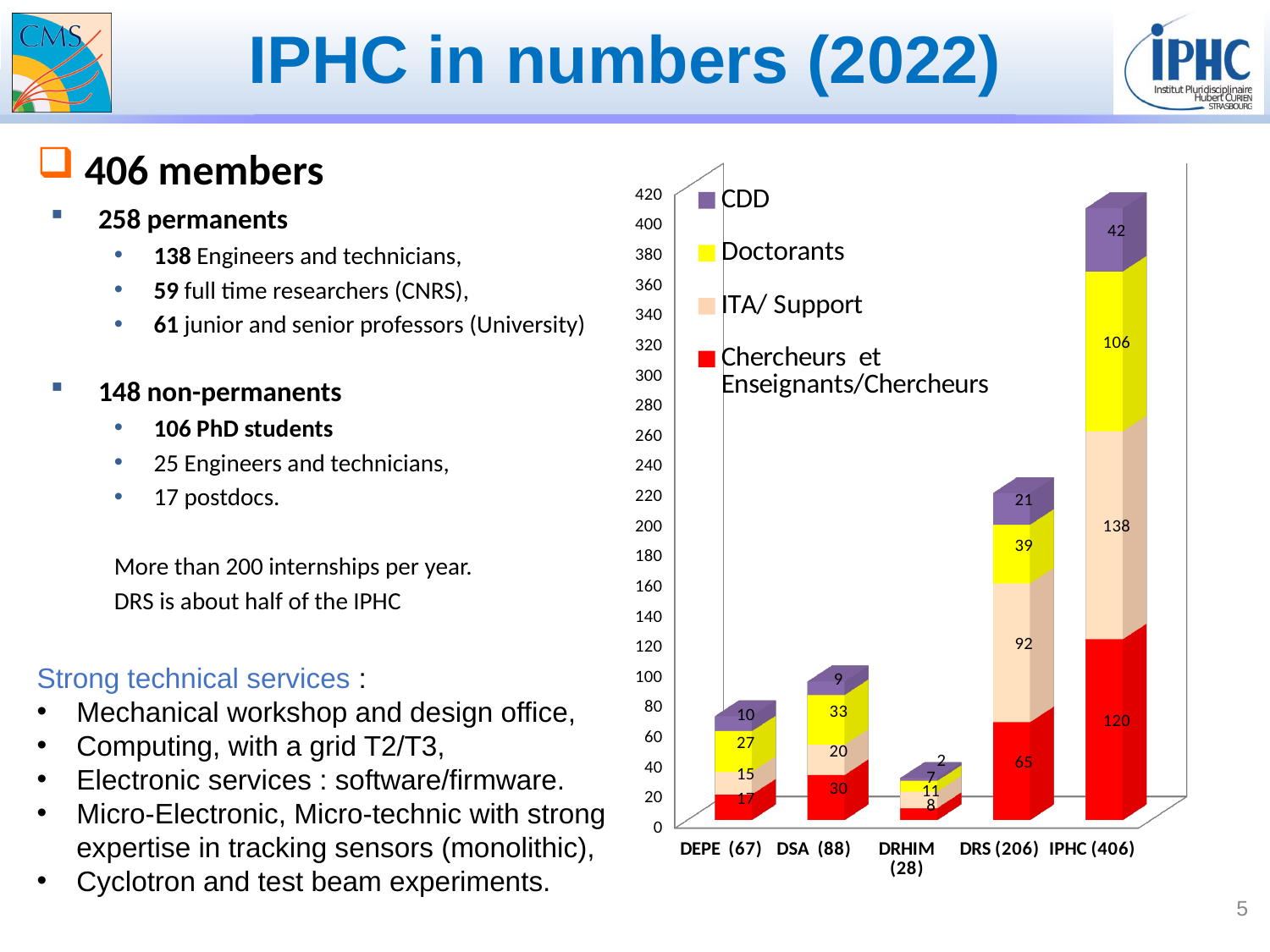
What is the value of the ITA/ Support segment for DSA (88)? 20 What is the value of the CDD segment for DEPE (67)? 10 How many series does the legend list? 4 Which category has the tallest stacked bar? IPHC (406) How many categories are shown on the x axis? 5 What is the value of the Doctorants segment for DRS (206)? 39 What is the value of the Chercheurs et Enseignants/Chercheurs segment for IPHC (406)? 120 Which category has the shortest stacked bar? DRHIM (28) What is the total of the stacked bar for IPHC (406)? 406 What kind of chart is shown on the slide? Stacked bar chart Which has the larger Chercheurs et Enseignants/Chercheurs value, DEPE (67) or DSA (88)? DSA (88) How much larger is the Doctorants value for IPHC (406) than for DRS (206)? 67